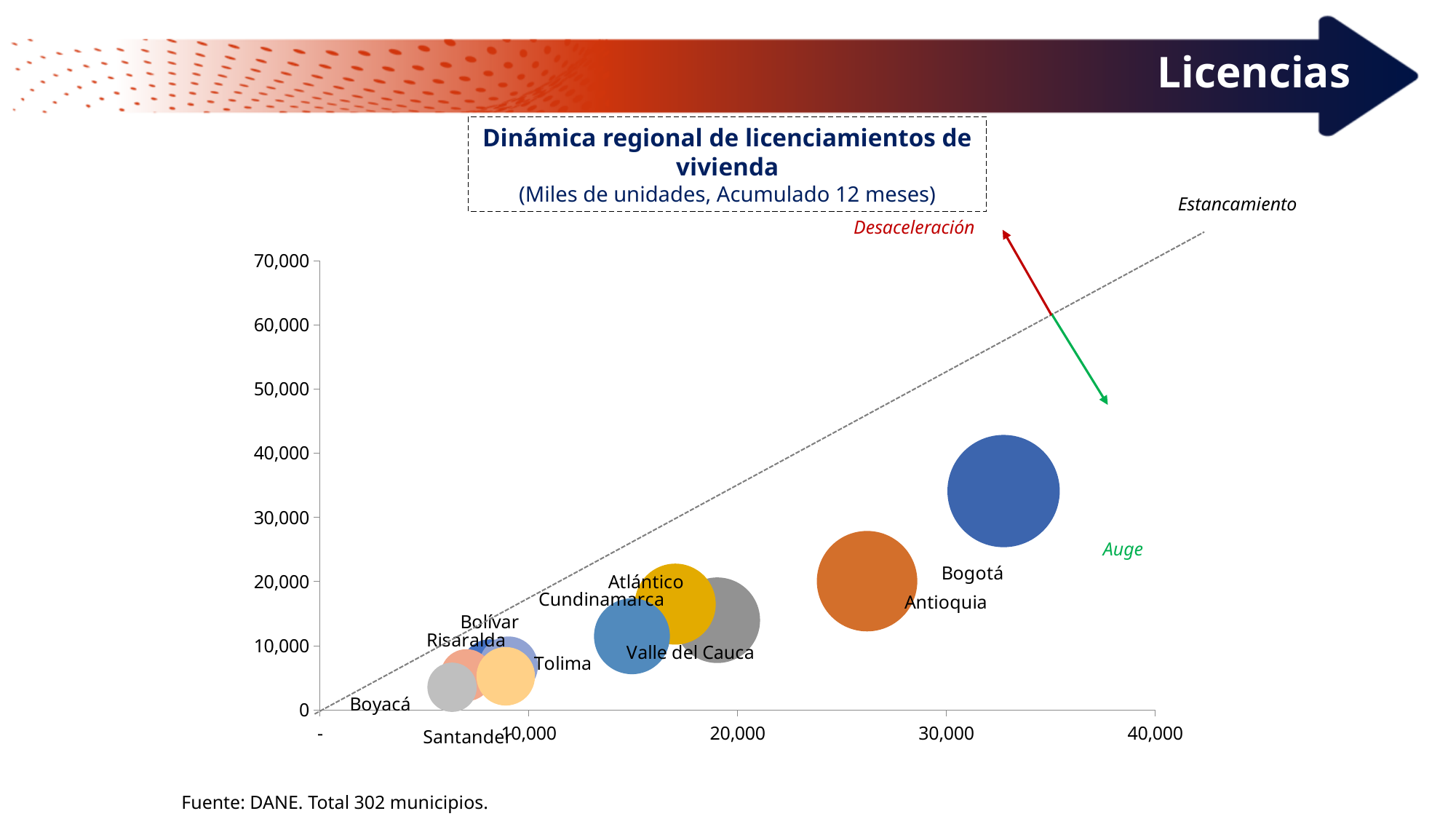
What kind of chart is shown on the slide? bubble chart How many labelled regions (bubbles) are plotted on the chart? 10 Is the vertical-axis value for Boyacá greater or less than 10,000? less Which region is plotted furthest to the right on the horizontal axis? Bogotá Which region has the highest value on the vertical axis? Bogotá Which has the larger vertical-axis value, Bogotá or Antioquia? Bogotá Is the vertical-axis value for Antioquia greater or less than 30,000? less What is the highest tick label shown on the vertical axis? 70,000 Is the horizontal-axis value for Antioquia greater or less than 20,000? greater What is the title of the chart? Dinámica regional de licenciamientos de vivienda Do the bubbles' vertical-axis values generally rise or fall as you move right along the horizontal axis? rise